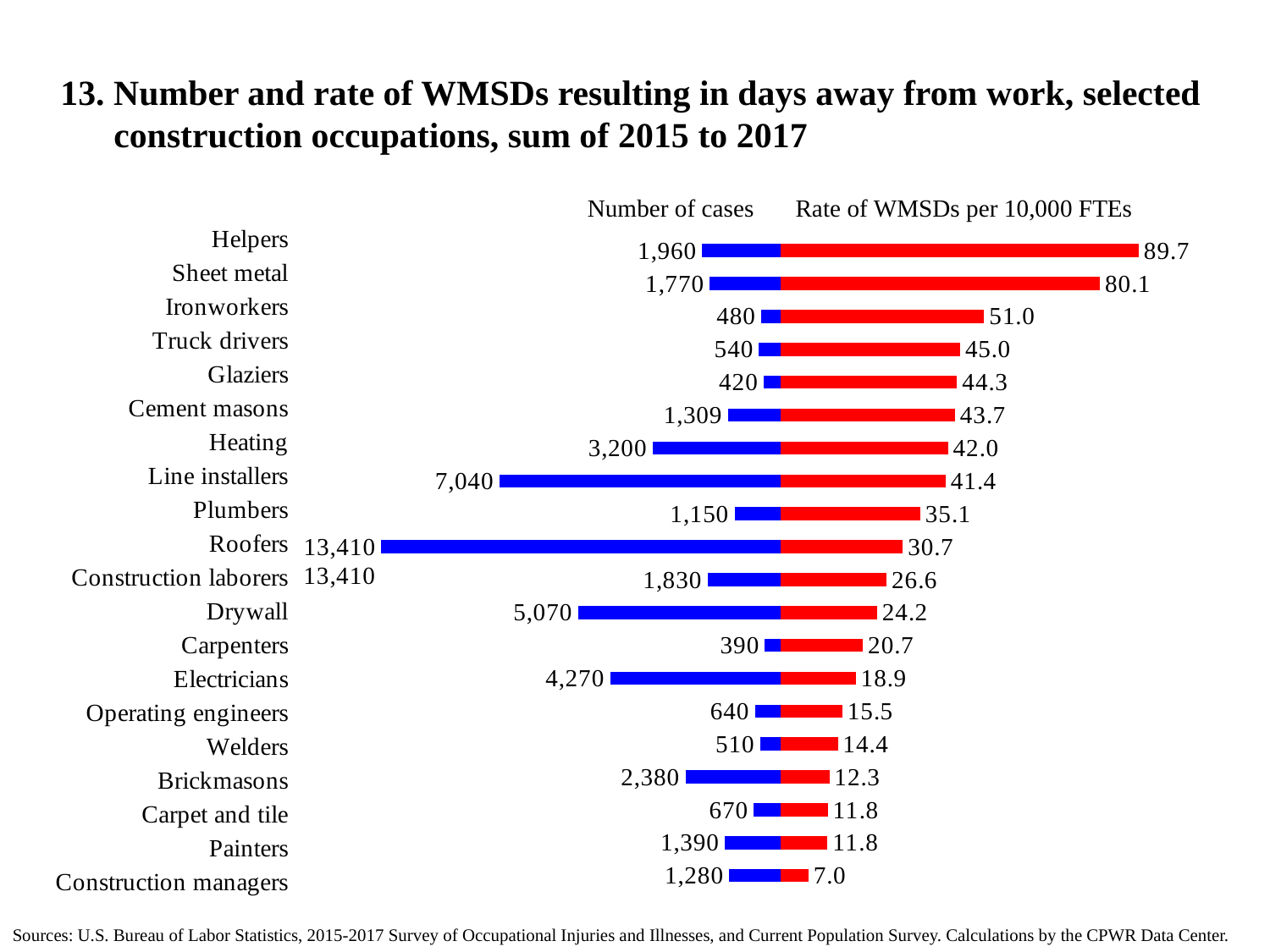
Which has more cases, Heating or Drywall? Drywall Which occupation has the highest rate of WMSDs per 10,000 FTEs? Helpers What is the rate of WMSDs per 10,000 FTEs for Carpenters? 20.7 What is the difference in number of cases between Line installers and Heating? 3,840 Which occupation has the lowest rate of WMSDs per 10,000 FTEs? Construction managers What is the number of cases for Sheet metal? 1,770 Which colour represents the Number of cases series? Blue How many series does the chart show? 2 What kind of chart is shown on the slide? Bar chart What is the difference between the rate of WMSDs for Helpers and for Sheet metal? 9.6 What is the rate of WMSDs per 10,000 FTEs for Helpers? 89.7 What is the number of cases for Electricians? 4,270